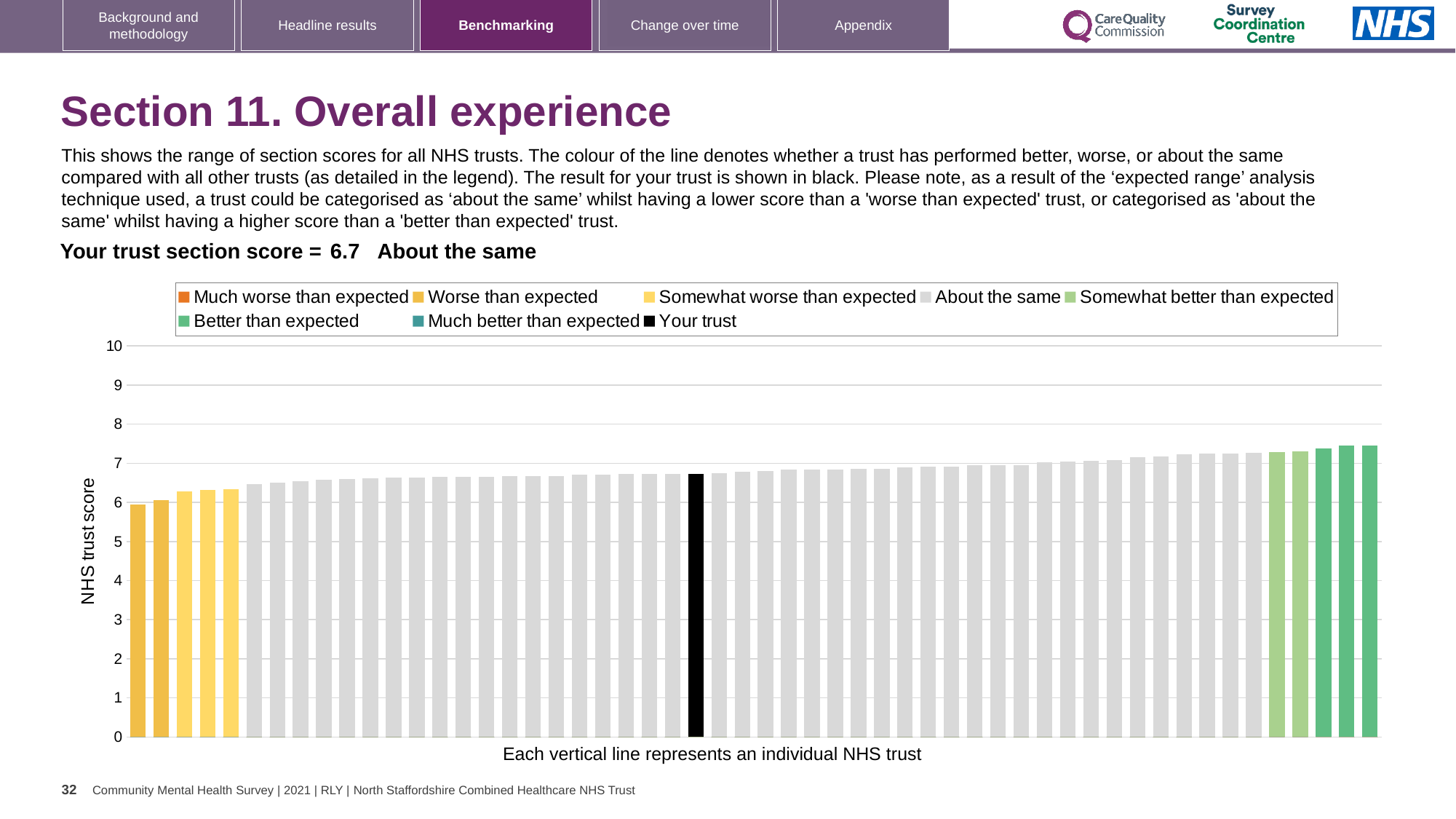
What kind of chart is shown on the slide? bar chart Which is larger: the value for your trust (black bar) or the value for the leftmost bar? your trust Do the bar values rise or fall from left to right along the x axis? rise Is the value for your trust greater or less than 5? greater Which is larger: the value for your trust (black bar) or the value for the rightmost bar? the rightmost bar How many entries does the chart legend list? 8 Which benchmarking category is your trust placed in for this section? About the same Is the value for the highest bar on the chart greater or less than 8? less What is the title of the vertical axis? NHS trust score Is the value for the lowest bar on the chart greater or less than 5? greater What is the section score for your trust shown on the slide? 6.7